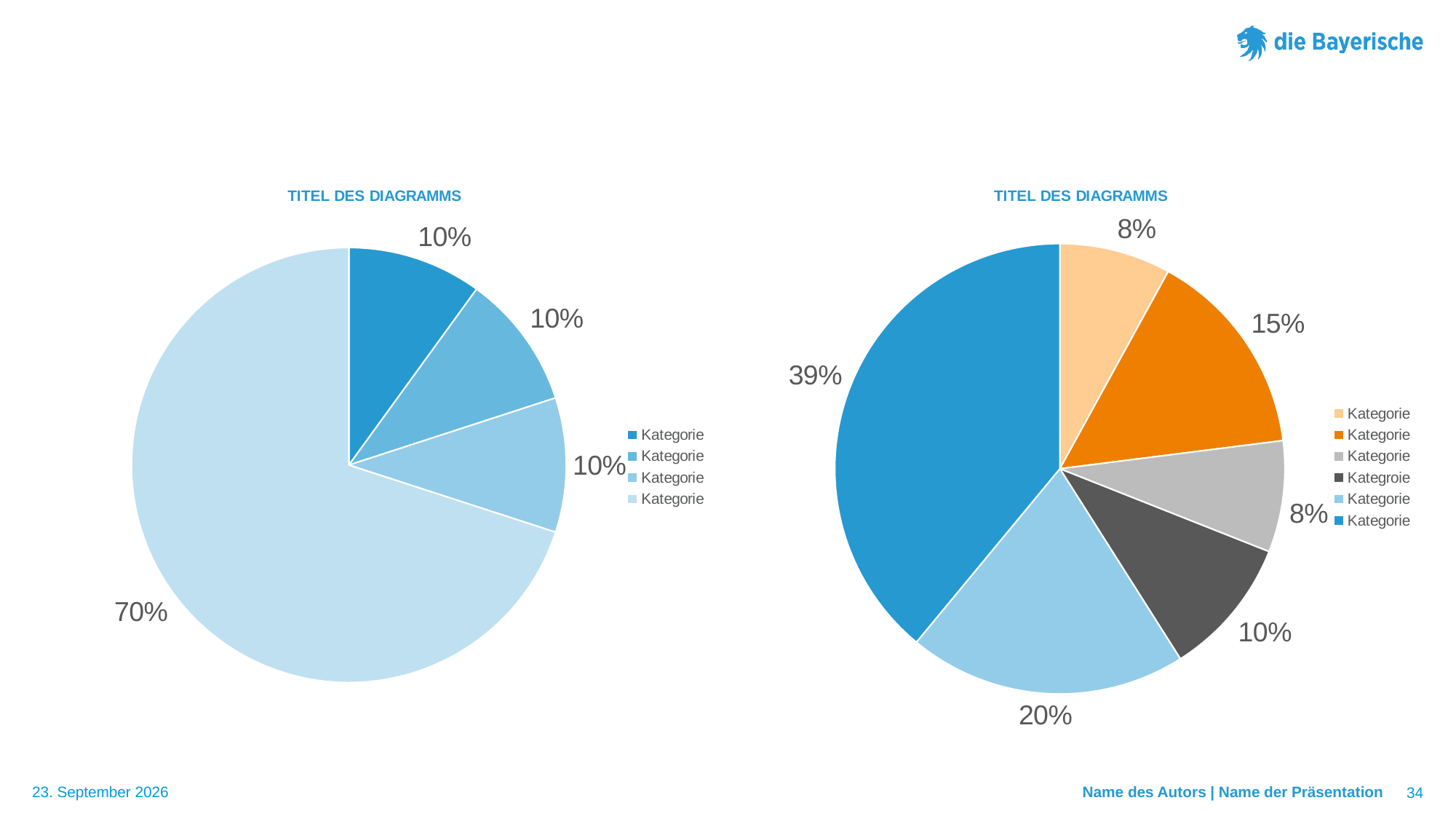
In the right pie chart, what share does the dark orange slice have? 15% In the left pie chart, what share does the largest slice (the light blue one) have? 70% What kind of chart is the chart on the left of the slide? pie chart In the left pie chart, how many slices does the pie have? 4 What kind of chart is the chart on the right of the slide? pie chart How many entries does the legend of the right pie chart list? 6 In the right pie chart, what share does the light blue slice at the bottom have? 20% In the right pie chart, how many slices does the pie have? 6 In the right pie chart, what share does the largest slice (the dark blue one) have? 39% In the right pie chart, what is the difference between the largest slice (39%) and the 20% slice? 19% In the left pie chart, what is the difference between the 70% slice and one of the 10% slices? 60% In the right pie chart, which is larger: the dark orange slice or the dark grey slice? the dark orange slice (15%)